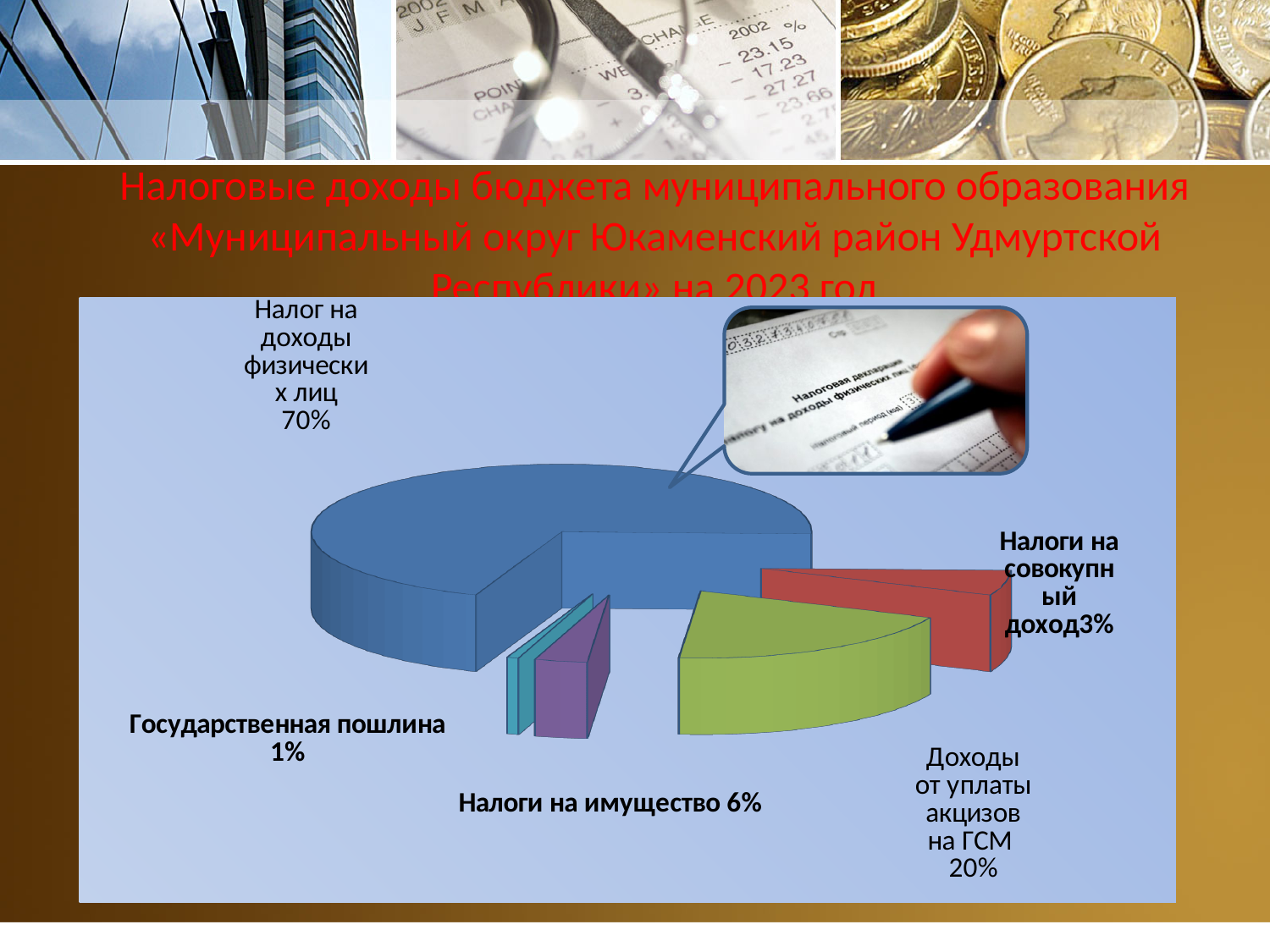
How many categories (slices) are shown in the pie chart? 5 What share is shown for "Налоги на совокупный доход"? 3% Which category has the largest share of the pie? Налог на доходы физических лиц Which is larger: the share for "Налоги на имущество" or the share for "Налоги на совокупный доход"? Налоги на имущество What share is shown for "Налоги на имущество"? 6% Which category has the smallest share of the pie? Государственная пошлина What share is shown for "Государственная пошлина"? 1% What share is shown for "Доходы от уплаты акцизов на ГСМ"? 20% What share of tax revenues does "Налог на доходы физических лиц" account for? 70% What kind of chart is shown on the slide? Pie chart What is the difference in percentage points between "Налог на доходы физических лиц" and "Доходы от уплаты акцизов на ГСМ"? 50 percentage points What colour is the slice representing "Налог на доходы физических лиц"? Blue